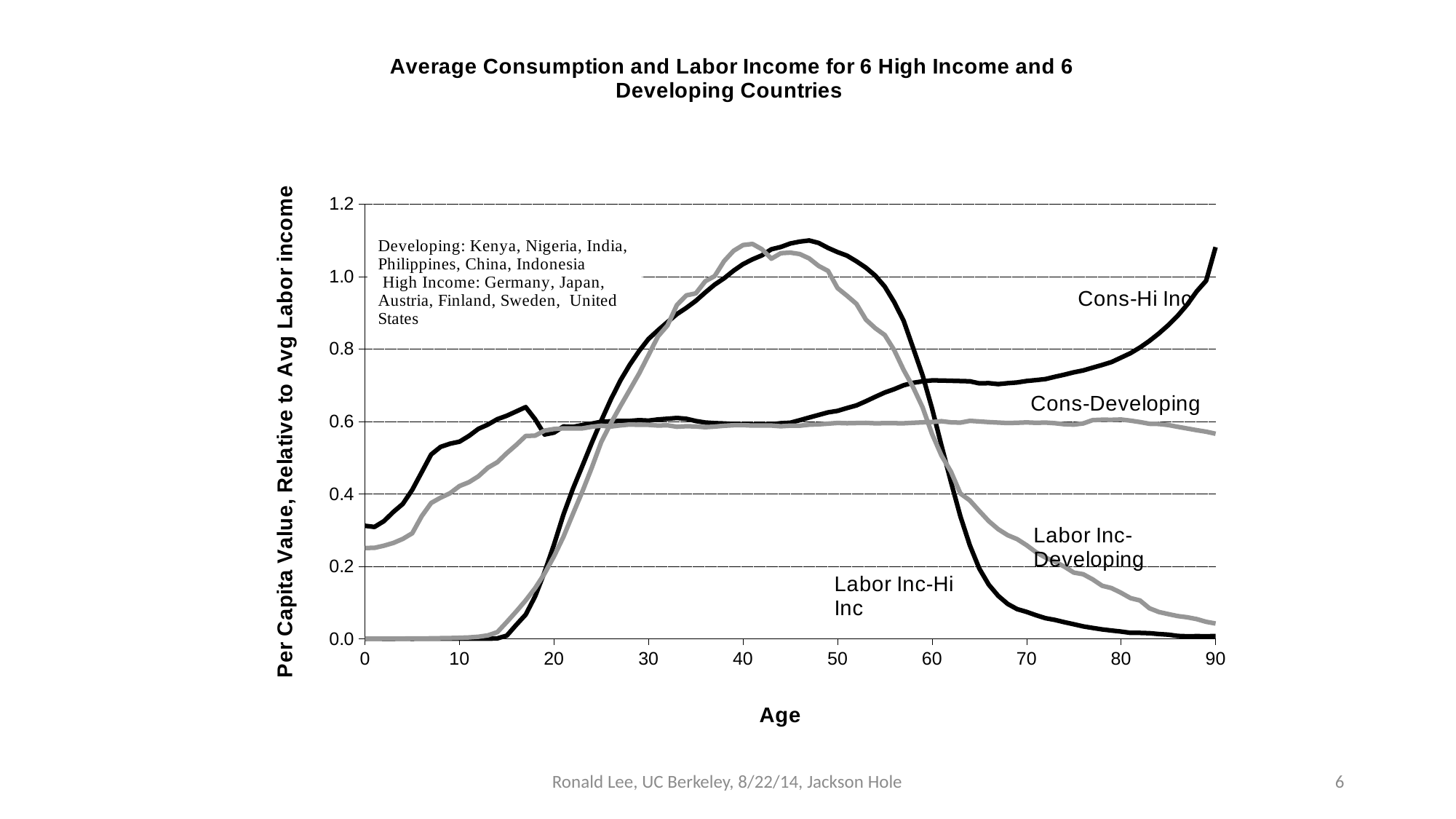
At age 80, which is larger: Labor Inc-Developing or Labor Inc-Hi Inc? Labor Inc-Developing Is the value of Cons-Hi Inc at age 90 greater or less than 1.0? greater Is the value of Cons-Developing at age 0 greater or less than 0.4? less Is the value of Labor Inc-Developing at age 90 greater or less than 0.2? less How many series (lines) are labeled on the chart? 4 Does the Cons-Hi Inc line rise or fall between age 60 and age 90? Rise At age 90, which is larger: Cons-Hi Inc or Cons-Developing? Cons-Hi Inc What is the label of the x axis? Age Does the Labor Inc-Hi Inc line rise or fall between age 50 and age 70? Fall What is the title of the chart? Average Consumption and Labor Income for 6 High Income and 6 Developing Countries What kind of chart is shown on the slide? Line chart